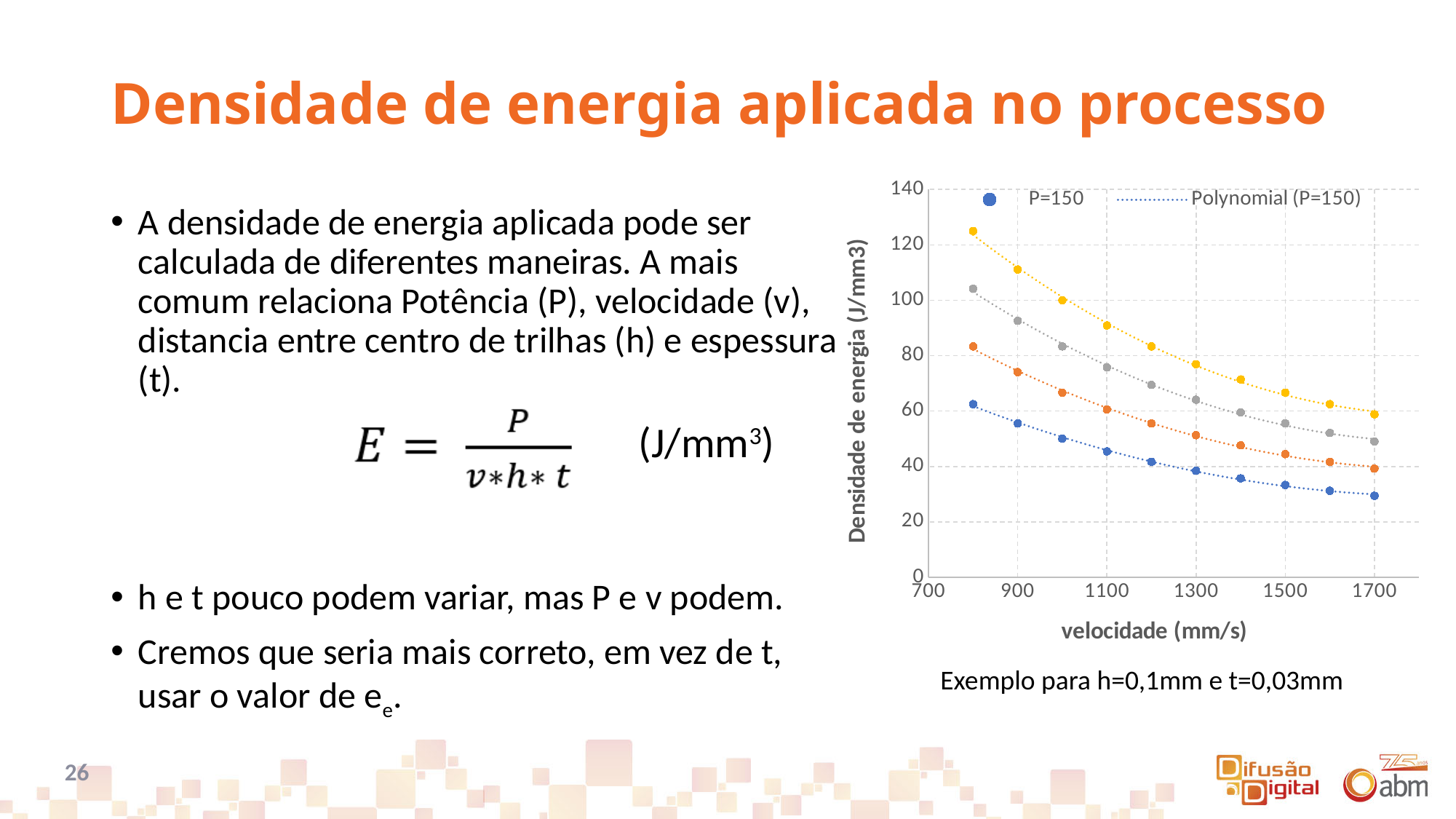
Is the value of the P=150 series at velocidade 1700 mm/s greater or less than 40? less Do the values of the P=150 series rise or fall as velocidade increases? fall Is the value of the P=150 series at velocidade 1100 mm/s greater or less than 40? greater At which velocidade does the P=150 series reach its highest value? 800 mm/s How many data points does the P=150 series have? 10 What is the title of the y axis of the chart? Densidade de energia (J/mm3) What is the title of the x axis of the chart? velocidade (mm/s) What kind of chart is shown on the slide? scatter chart Is the value of the P=150 series at velocidade 1500 mm/s greater or less than 40? less Which is larger for the P=150 series: the value at velocidade 800 mm/s or at 1700 mm/s? 800 mm/s At which velocidade does the P=150 series reach its lowest value? 1700 mm/s